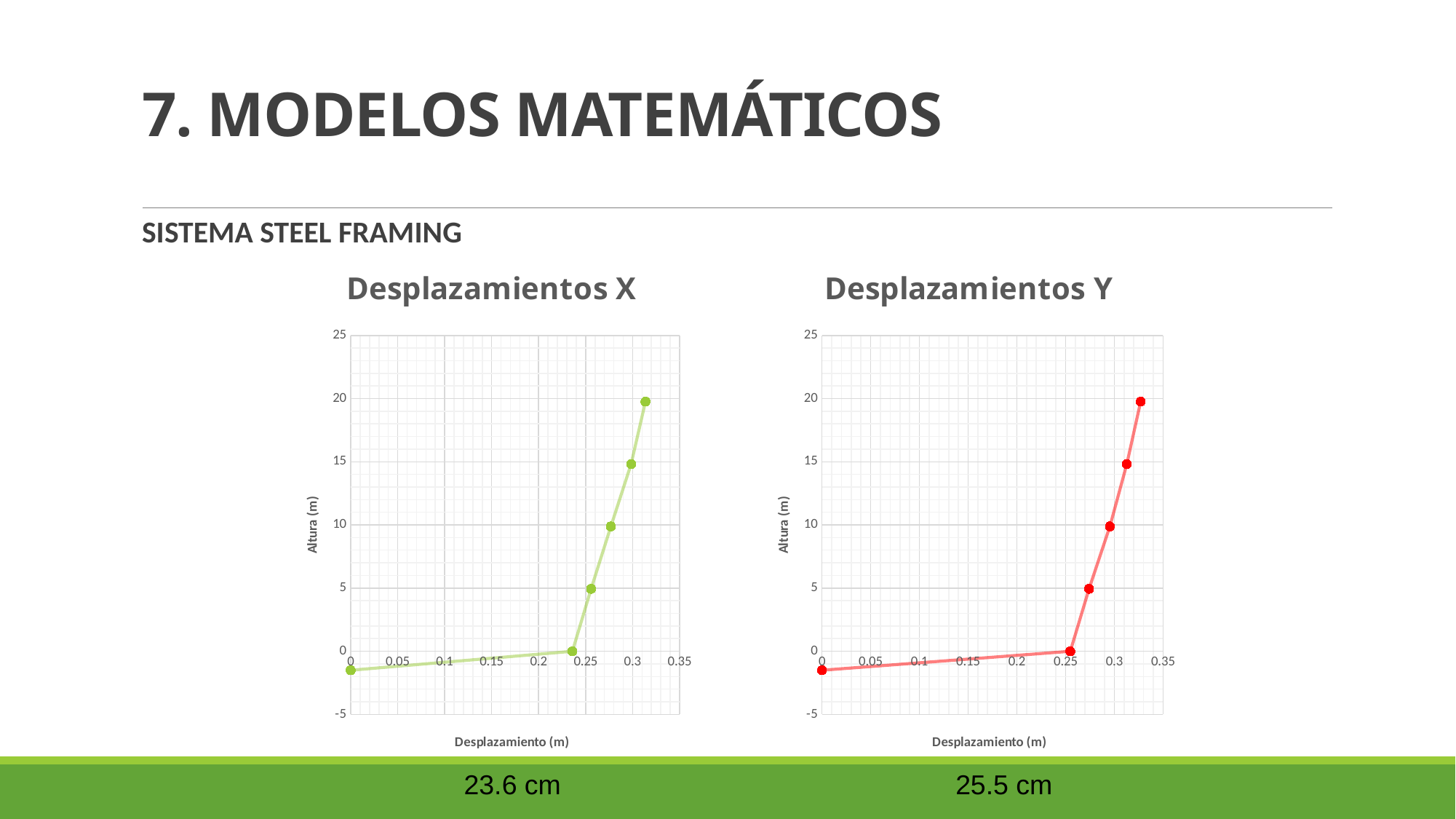
How many data points are plotted in the "Desplazamientos Y" chart? 6 In the "Desplazamientos X" chart, is the displacement of the highest point (at about 20 m altura) greater or less than 0.3? greater In the "Desplazamientos Y" chart, does the altura rise or fall as the desplazamiento increases? rises What colour is the line in the "Desplazamientos Y" chart? red What kind of chart is "Desplazamientos X"? line chart In the "Desplazamientos X" chart, is the displacement of the point at 0 m altura greater or less than 0.25? less In the "Desplazamientos X" chart, is the displacement of the point at 10 m altura greater or less than 0.25? greater What is the y-axis title of the "Desplazamientos X" chart? Altura (m) How many data points are plotted in the "Desplazamientos X" chart? 6